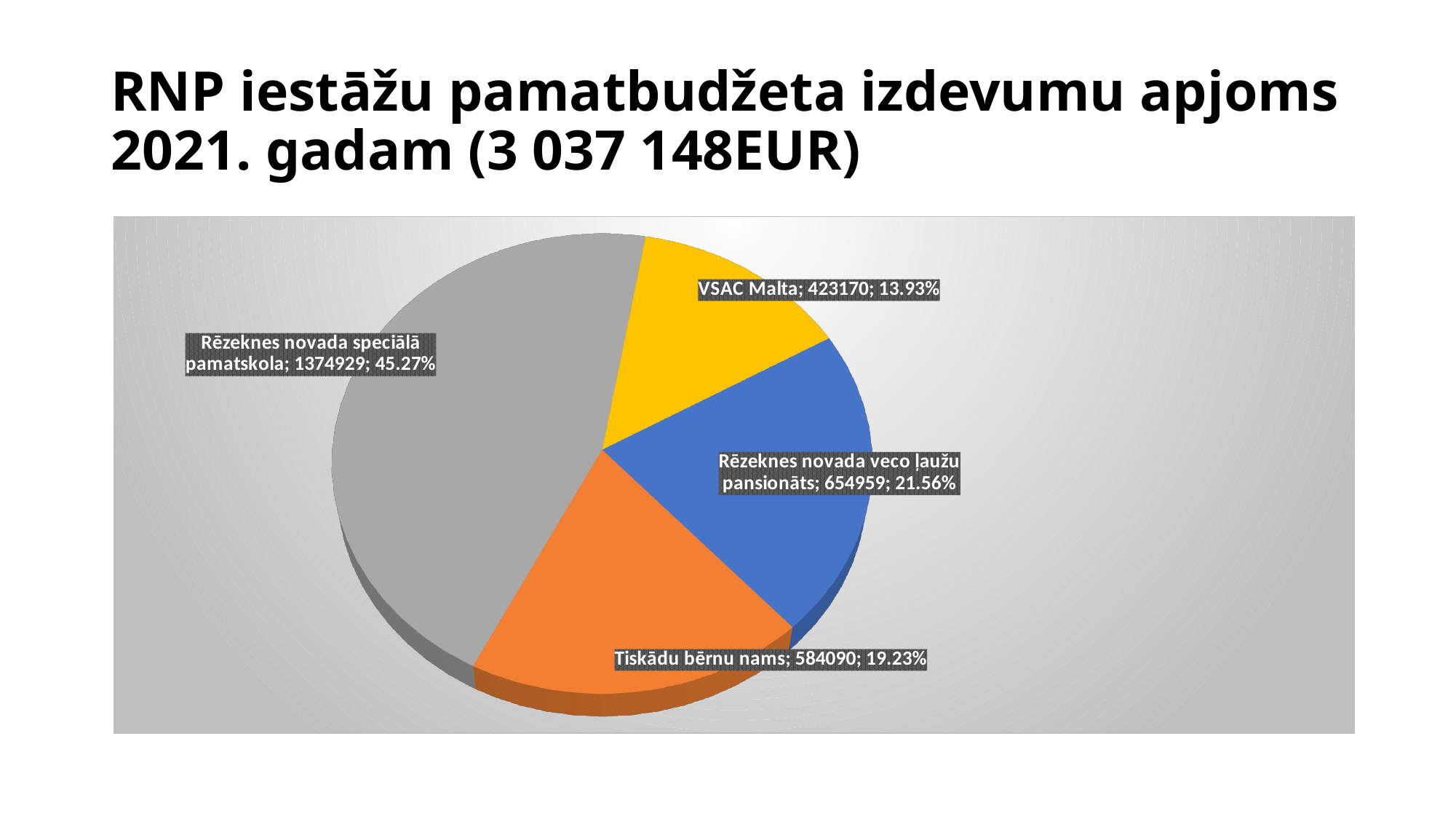
Which is larger, the value for Tiskādu bērnu nams or the value for VSAC Malta? Tiskādu bērnu nams What is the value for Rēzeknes novada speciālā pamatskola? 1374929 Which category has the smallest slice? VSAC Malta What is the value for Tiskādu bērnu nams? 584090 What is the value for Rēzeknes novada veco ļaužu pansionāts? 654959 What kind of chart is shown on the slide? Pie chart What share of the pie does VSAC Malta represent? 13.93% Which category has the largest slice? Rēzeknes novada speciālā pamatskola What is the value for VSAC Malta? 423170 How many slices does the pie chart have? 4 What share of the pie does Rēzeknes novada speciālā pamatskola represent? 45.27% What is the difference between the values for Rēzeknes novada veco ļaužu pansionāts and Tiskādu bērnu nams? 70869